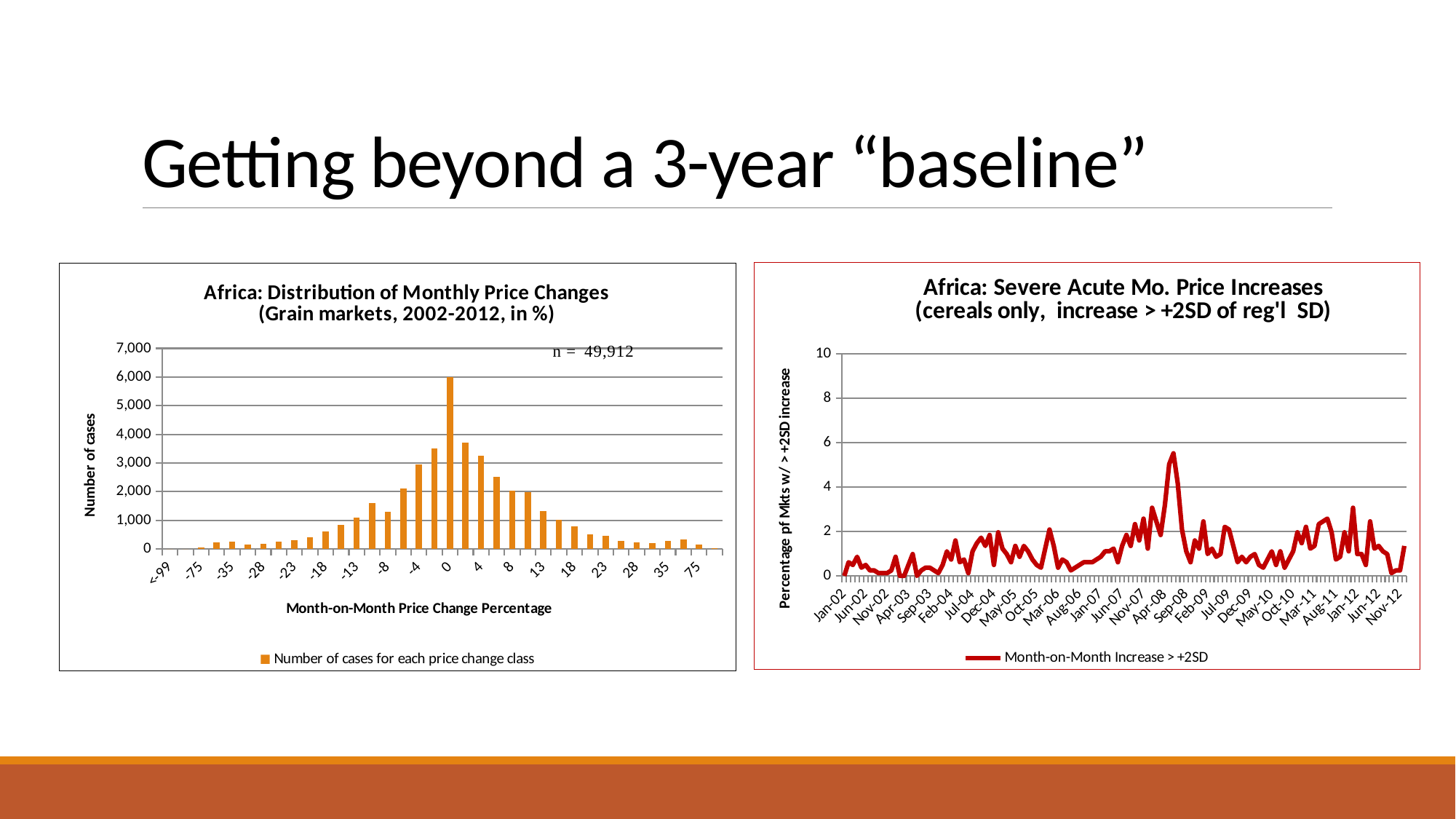
In the left chart, 'Africa: Distribution of Monthly Price Changes', what sample size n is shown on the chart? n = 49,912 What kind of chart is the left chart, 'Africa: Distribution of Monthly Price Changes'? bar chart What kind of chart is the right chart, 'Africa: Severe Acute Mo. Price Increases'? line chart In the left chart, 'Africa: Distribution of Monthly Price Changes', which price change class has the highest number of cases? 0 In the right chart, 'Africa: Severe Acute Mo. Price Increases', is the peak value around Sep-08 greater or less than 4? greater In the left chart, 'Africa: Distribution of Monthly Price Changes', is the number of cases for the 4 price change class greater or less than 4,000? less In the left chart, 'Africa: Distribution of Monthly Price Changes', which has more cases: the 0 class or the 4 class? 0 How many series does the legend of the right chart, 'Africa: Severe Acute Mo. Price Increases', list? 1 How many series does the legend of the left chart, 'Africa: Distribution of Monthly Price Changes', list? 1 In the left chart, 'Africa: Distribution of Monthly Price Changes', is the number of cases for the 0 price change class greater or less than 5,000? greater What is the legend entry of the right chart, 'Africa: Severe Acute Mo. Price Increases'? Month-on-Month Increase > +2SD